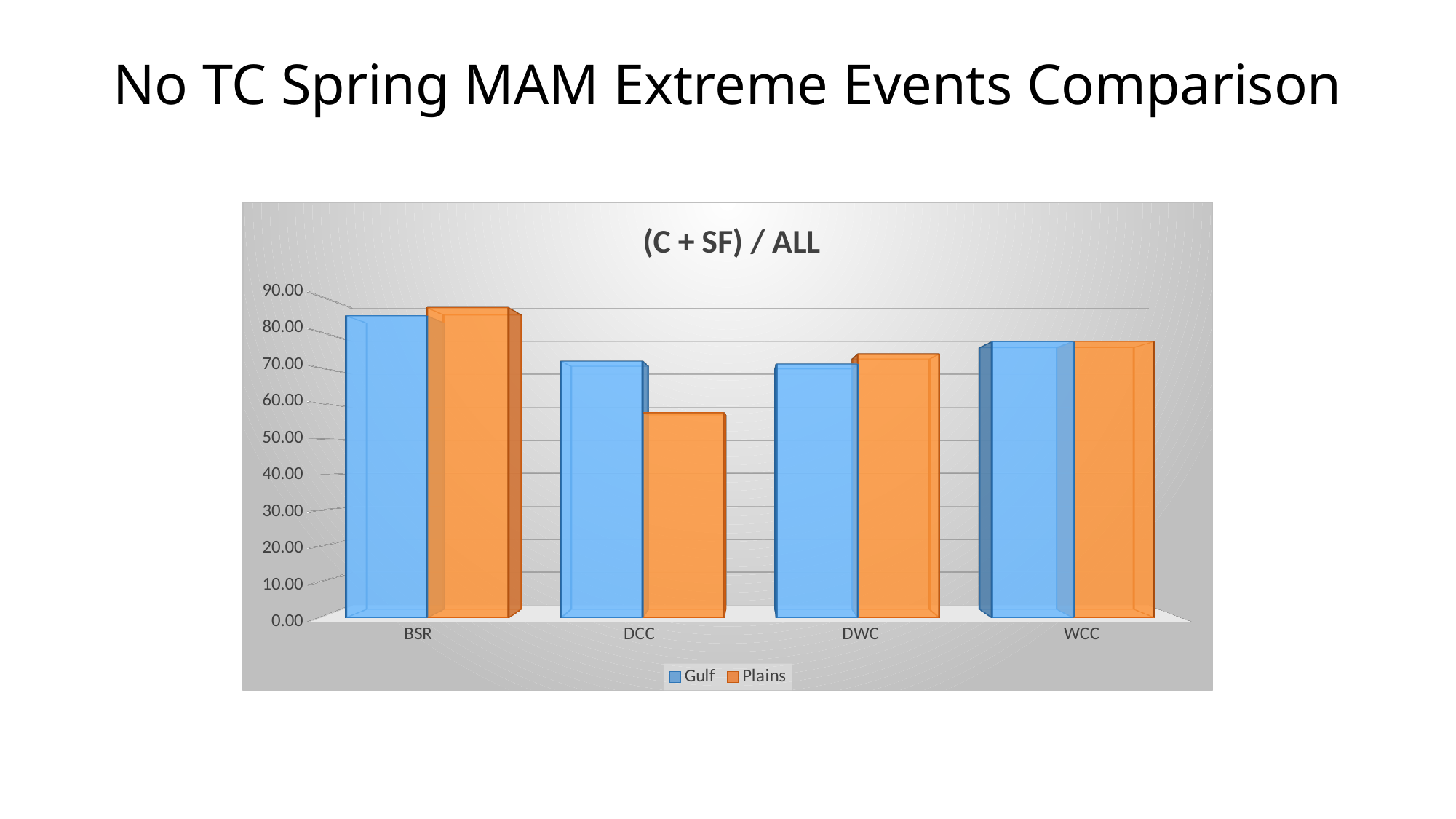
What is the title printed above the chart's plot area? (C + SF) / ALL How many series does the chart's legend list? 2 Is the Gulf value for BSR greater or less than 80.00? greater Is the Gulf value for WCC greater or less than 70.00? greater How many categories are shown on the x axis of the chart? 4 Is the Plains value for DCC greater or less than 60.00? less What kind of chart is shown on the slide? bar chart Which category has the highest Gulf value? BSR For DCC, which series has the larger value, Gulf or Plains? Gulf Which category has the lowest Plains value? DCC Which category has the highest Plains value? BSR Which colour represents the Plains series in the chart? orange